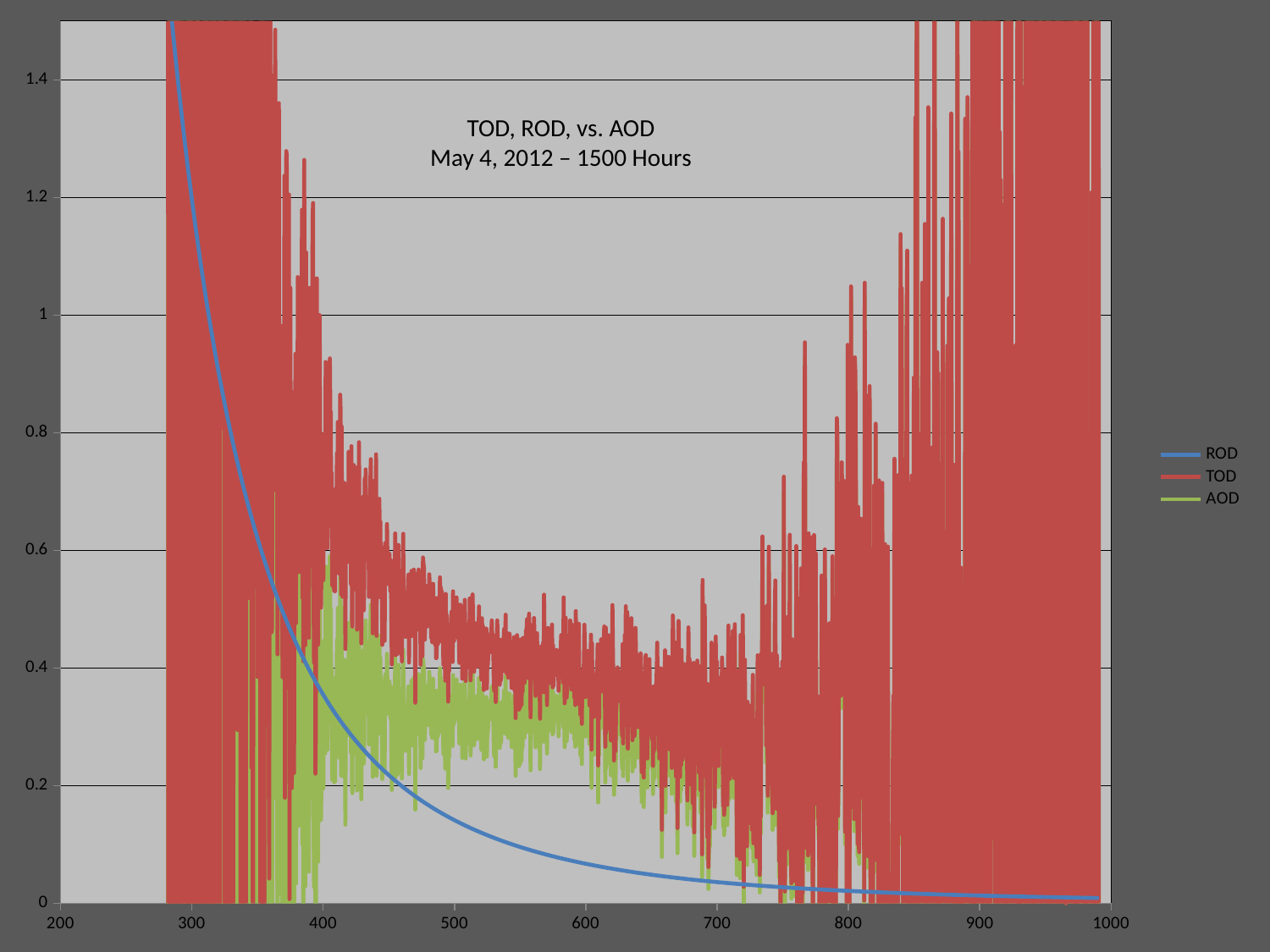
Is the value of ROD at x = 700 greater or less than 0.2? less At x = 500, which series has the larger value, TOD or ROD? TOD How many series does the legend list? 3 Which series has the highest value at x = 300? TOD Does the ROD series rise or fall as the x axis increases? fall At x = 600, which series has the larger value, AOD or ROD? AOD What kind of chart is shown on the slide? line chart Is the value of ROD at x = 400 greater or less than 0.2? greater Which series is drawn in blue? ROD What is the title of the chart? TOD, ROD, vs. AOD May 4, 2012 – 1500 Hours Is the value of ROD at x = 500 greater or less than 0.2? less